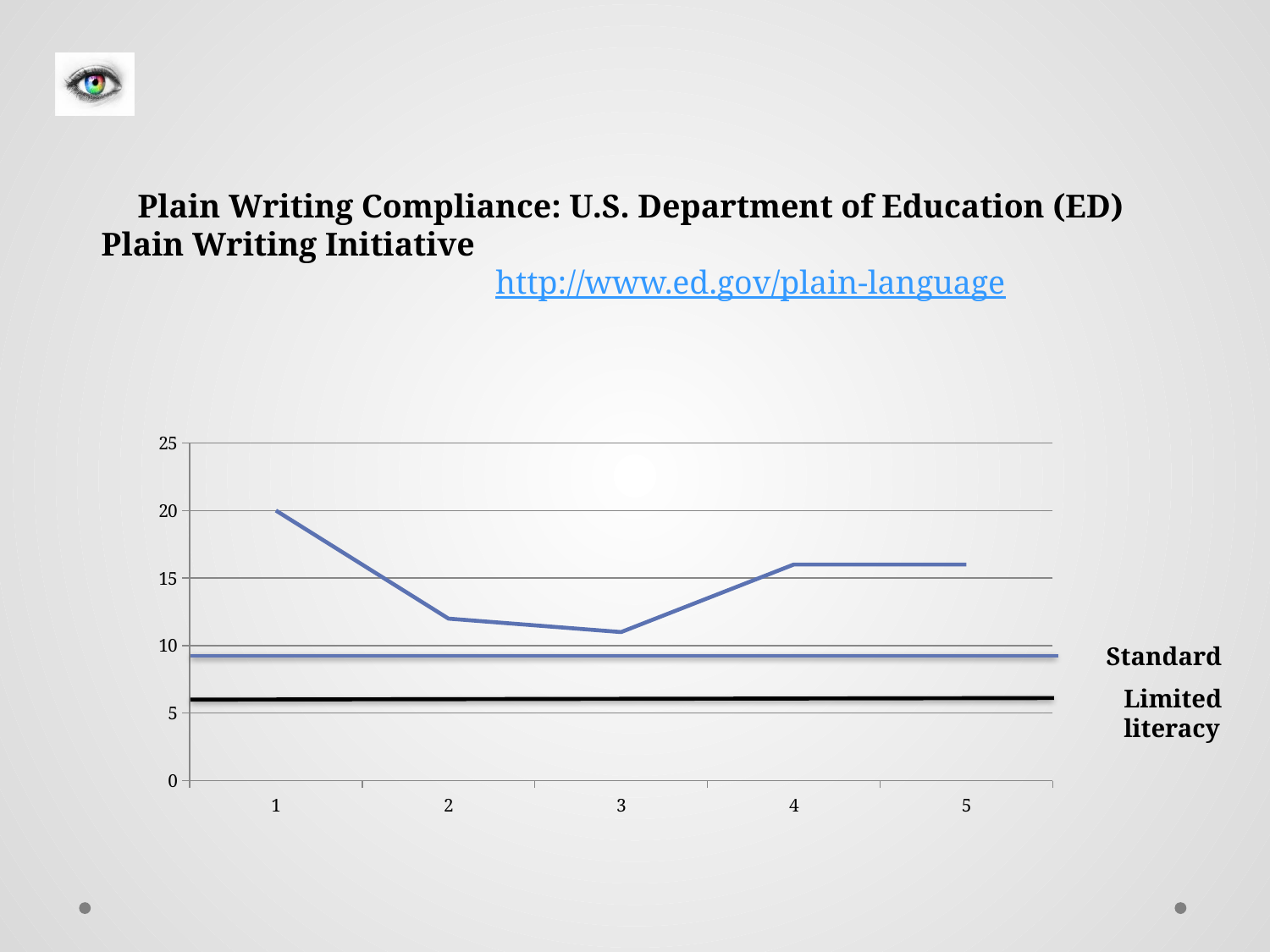
How many points are plotted along the x axis of the main line? 5 Is the value of the main line at x = 4 greater or less than 15? greater What is the value of the main line at x = 1? 20 Is the horizontal 'Standard' line greater or less than 10? less At which x value is the main line lowest? 3 Is the value of the main line at x = 3 greater or less than 10? greater Does the main line rise or fall from x = 1 to x = 3? fall What kind of chart is shown on the slide? line chart At which x value is the main line highest? 1 Which is larger, the main line's value at x = 1 or at x = 4? x = 1